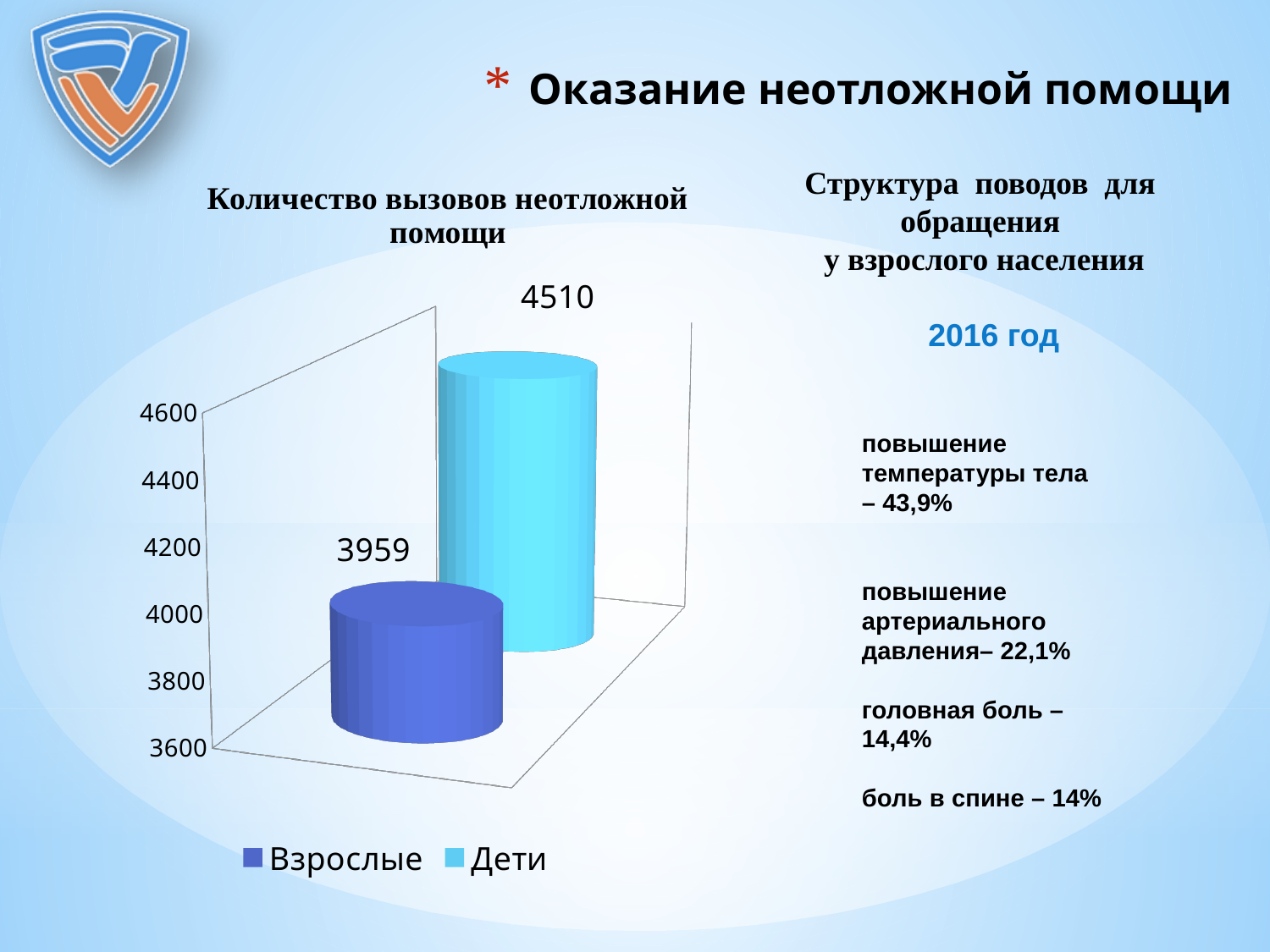
Is the value for Взрослые greater or less than 4000? less How many bars are plotted in the chart? 2 How many series does the chart legend list? 2 What is the difference between the values for Дети and Взрослые? 551 Which series has the highest value in the chart? Дети What is the value for Взрослые in the chart "Количество вызовов неотложной помощи"? 3959 Which is larger, the value for Взрослые or the value for Дети? Дети Is the value for Дети greater or less than 4400? greater What kind of chart is shown on the slide? bar chart Which series has the lowest value in the chart? Взрослые What is the title of the chart on the slide? Количество вызовов неотложной помощи What is the value for Дети in the chart "Количество вызовов неотложной помощи"? 4510